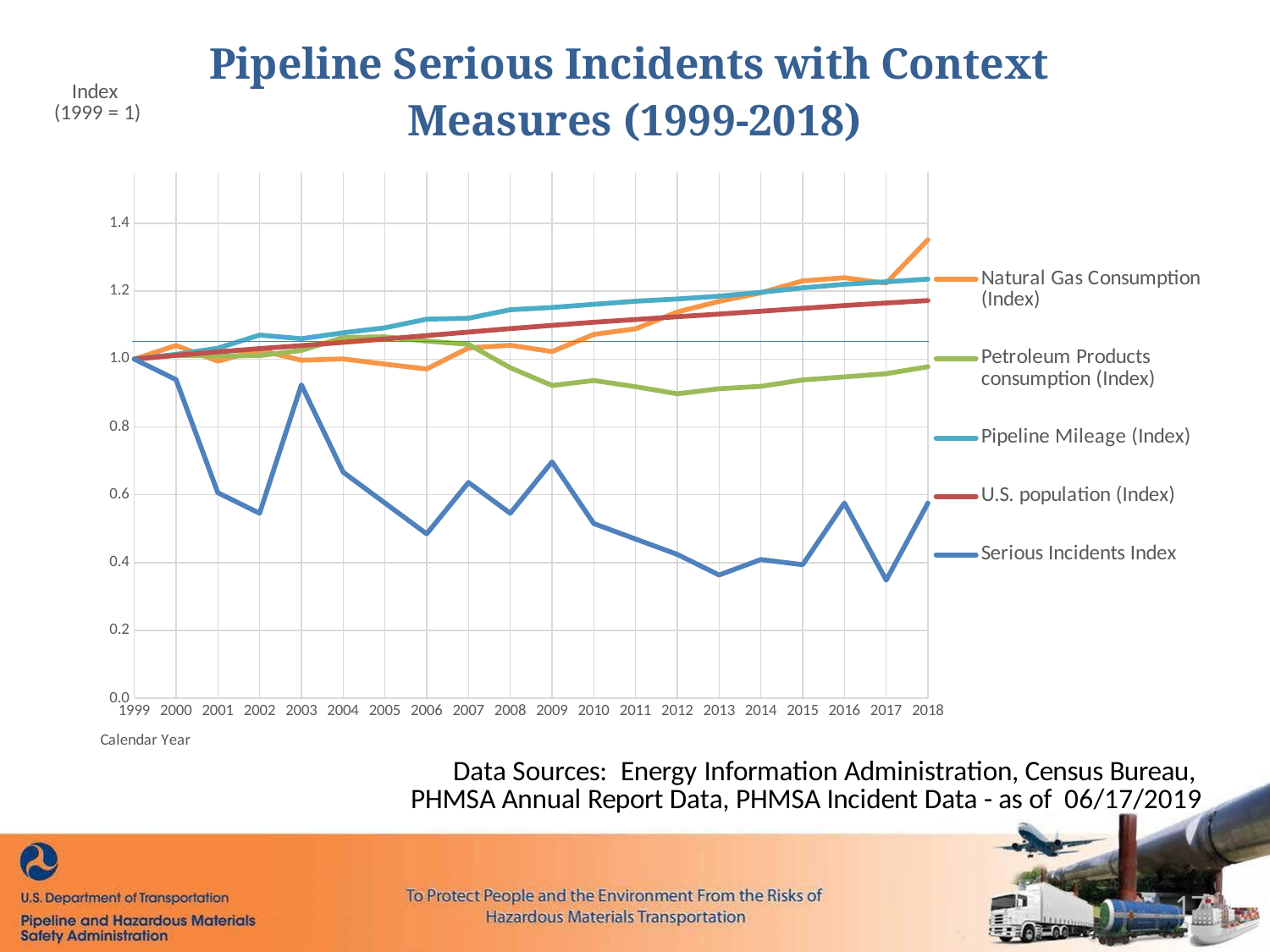
What kind of chart is shown on the slide? line chart Which is larger, the Serious Incidents Index in 2002 or in 2003? 2003 Which series has the lowest value in 2018? Serious Incidents Index How many series does the legend list? 5 Is the Natural Gas Consumption (Index) value for 2018 greater or less than 1.2? greater Is the Petroleum Products consumption (Index) value for 2012 greater or less than 1.0? less How many calendar years are plotted along the x axis? 20 Which series has the highest value in 2018? Natural Gas Consumption (Index) What is the label of the x axis? Calendar Year Is the Serious Incidents Index value for 2013 greater or less than 0.4? less What is the value of the Serious Incidents Index in 1999? 1.0 Does the U.S. population (Index) rise or fall from 1999 to 2018? rise